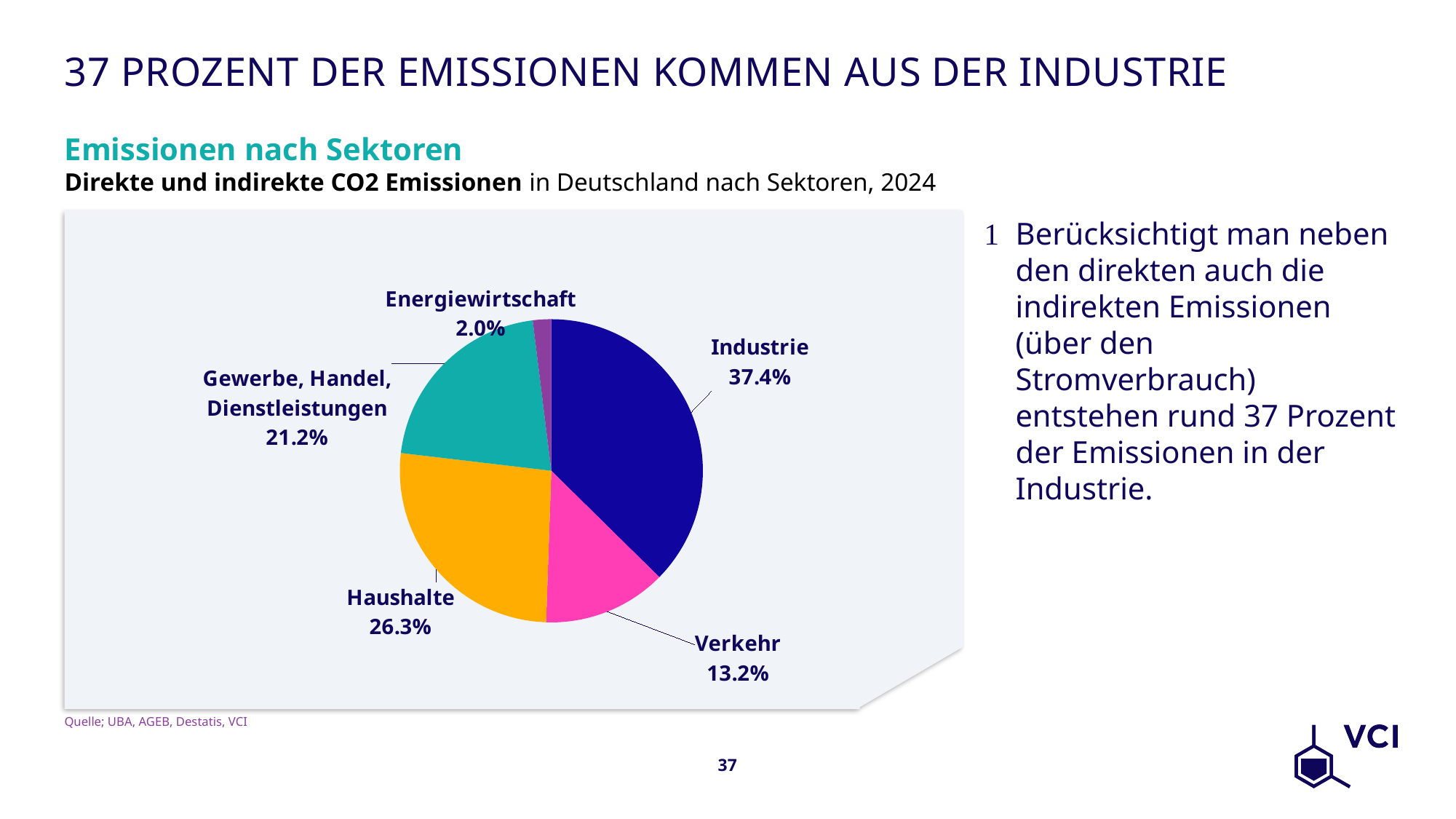
What percentage is shown for Verkehr? 13.2% Which is larger, the share for Haushalte or the share for Gewerbe, Handel, Dienstleistungen? Haushalte What is the difference in percentage points between Industrie and Haushalte? 11.1 What is the value shown for Haushalte? 26.3% How many sectors are shown in the pie chart? 5 What is the value for Gewerbe, Handel, Dienstleistungen? 21.2% Which sector has the smallest share of emissions? Energiewirtschaft Which sector has the largest share of emissions? Industrie What is the combined share of Verkehr and Energiewirtschaft? 15.2% What is the title of the chart? Emissionen nach Sektoren What kind of chart is shown on the slide? Pie chart What share of emissions does the Industrie slice represent? 37.4%